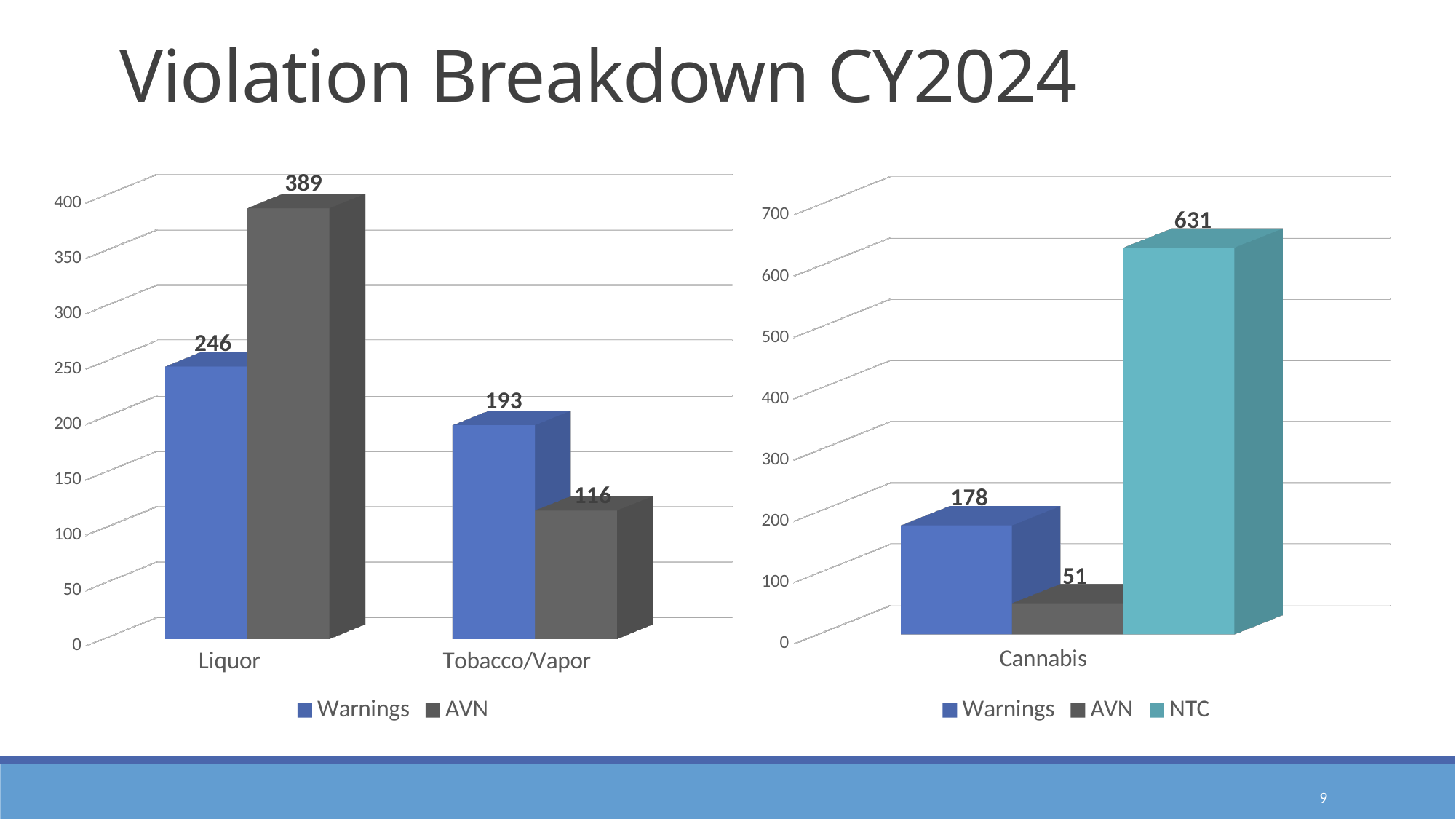
In the right chart (Cannabis), what is the NTC value? 631 How many categories are shown on the x axis of the left chart (Liquor and Tobacco/Vapor)? 2 In the left chart (Liquor and Tobacco/Vapor), which bar has the highest value? Liquor AVN In the left chart (Liquor and Tobacco/Vapor), which is larger for Tobacco/Vapor: Warnings or AVN? Warnings In the left chart (Liquor and Tobacco/Vapor), what is the Warnings value for Tobacco/Vapor? 193 In the left chart (Liquor and Tobacco/Vapor), what is the AVN value for Liquor? 389 What kind of chart is the right chart (Cannabis)? Bar chart In the right chart (Cannabis), which series has the lowest value? AVN In the right chart (Cannabis), what is the AVN value? 51 In the right chart (Cannabis), what is the difference between the NTC and Warnings values? 453 How many series does the legend of the right chart (Cannabis) list? 3 In the left chart (Liquor and Tobacco/Vapor), what is the difference between the AVN and Warnings values for Liquor? 143